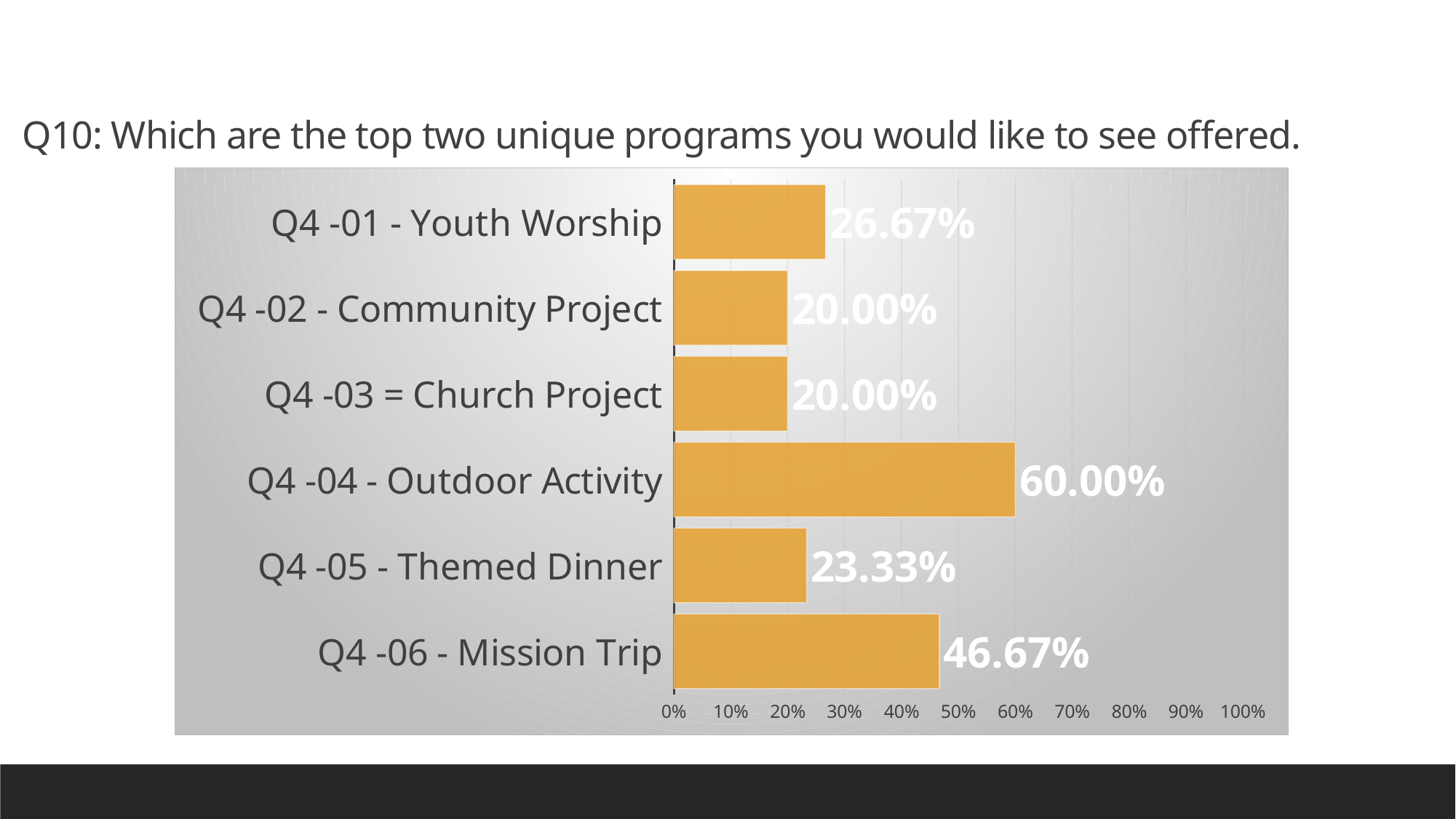
What is the difference between the values for Q4 -01 - Youth Worship and Q4 -02 - Community Project? 6.67% What is the value for Q4 -01 - Youth Worship? 26.67% What is the title of the slide above the chart? Q10: Which are the top two unique programs you would like to see offered. What is the value for Q4 -05 - Themed Dinner? 23.33% What is the difference between the values for Q4 -04 - Outdoor Activity and Q4 -06 - Mission Trip? 13.33% Which category has the highest value? Q4 -04 - Outdoor Activity How many categories are shown in the chart? 6 Which is larger, the value for Q4 -05 - Themed Dinner or the value for Q4 -01 - Youth Worship? Q4 -01 - Youth Worship Is the value for Q4 -06 - Mission Trip greater or less than 50%? less What is the value for Q4 -04 - Outdoor Activity? 60.00% What is the value for Q4 -06 - Mission Trip? 46.67% What kind of chart is shown on the slide? bar chart